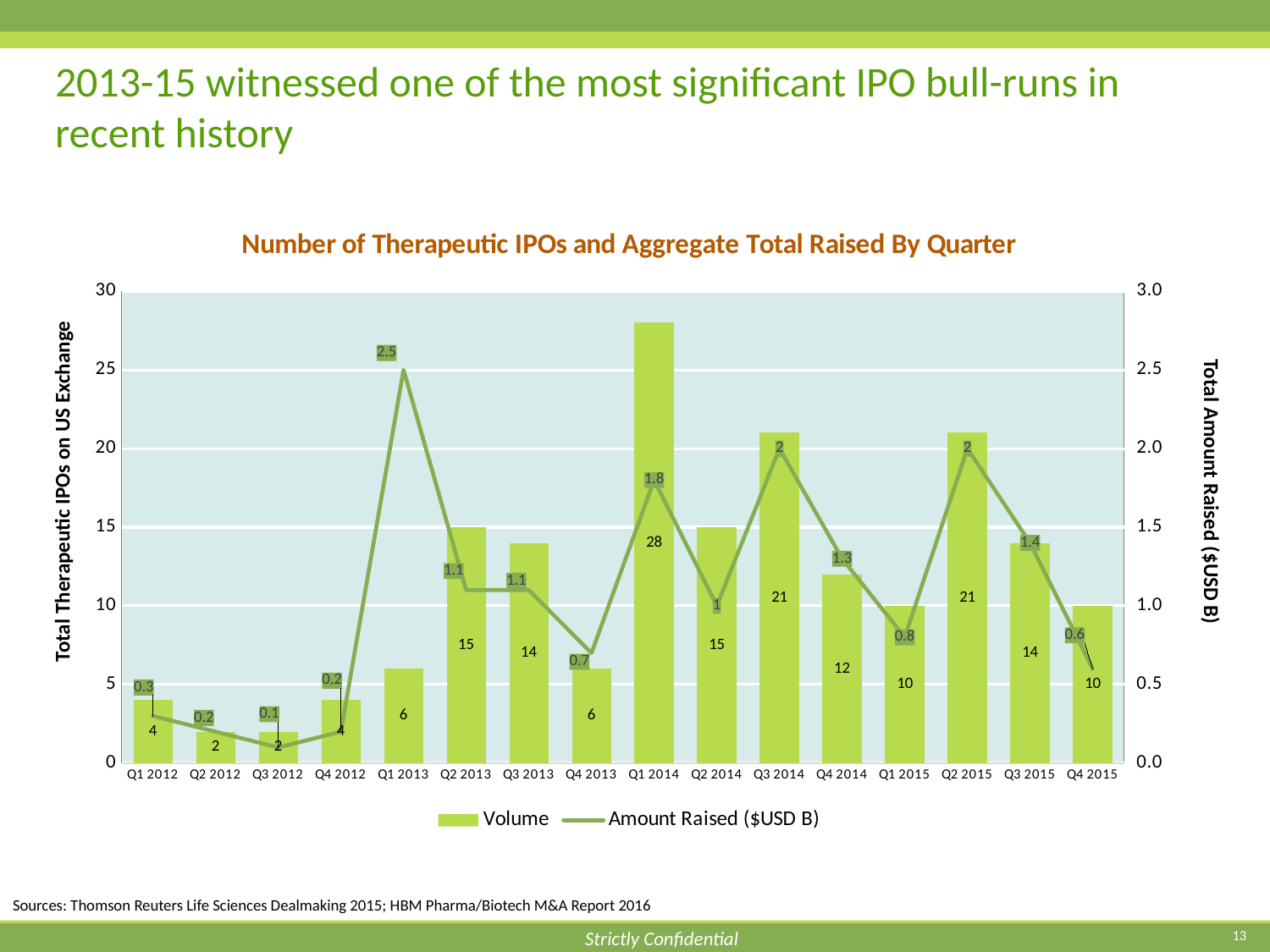
How many series does the legend list? 2 What kind of chart is this? Combined bar and line chart Which quarter has the highest Volume? Q1 2014 How many quarters are shown on the x axis? 16 Which is larger, the Amount Raised ($USD B) in Q1 2013 or in Q1 2014? Q1 2013 What is the title of the chart? Number of Therapeutic IPOs and Aggregate Total Raised By Quarter Does the Amount Raised ($USD B) rise or fall from Q2 2015 to Q4 2015? Fall What is the Volume value for Q4 2014? 12 What is the difference in Volume between Q1 2014 and Q3 2014? 7 What is the Volume value for Q1 2014? 28 Which quarter has the lowest Amount Raised ($USD B)? Q3 2012 What is the Amount Raised ($USD B) value for Q1 2013? 2.5